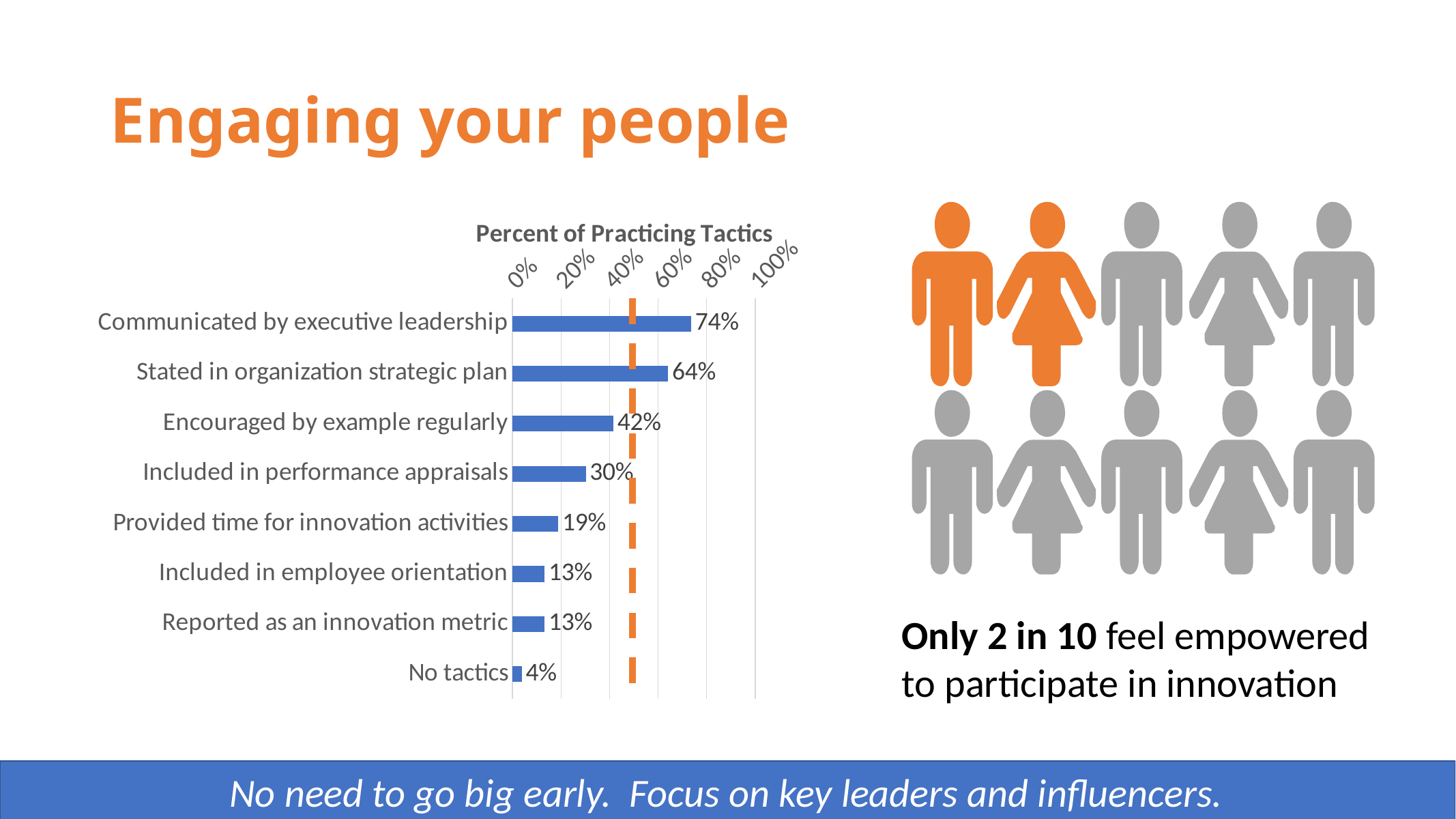
What is the title of the chart? Percent of Practicing Tactics What is the value for 'Communicated by executive leadership'? 74% What is the difference between 'Communicated by executive leadership' and 'Stated in organization strategic plan'? 10% What is the difference between 'Encouraged by example regularly' and 'Included in performance appraisals'? 12% What kind of chart is shown on the slide? bar chart Which is larger, 'Stated in organization strategic plan' or 'Encouraged by example regularly'? Stated in organization strategic plan Is the value for 'Stated in organization strategic plan' greater or less than 60%? greater What is the value for 'Included in performance appraisals'? 30% How many categories are shown in the chart? 8 Which category has the highest value? Communicated by executive leadership Which category has the lowest value? No tactics What is the value for 'Provided time for innovation activities'? 19%